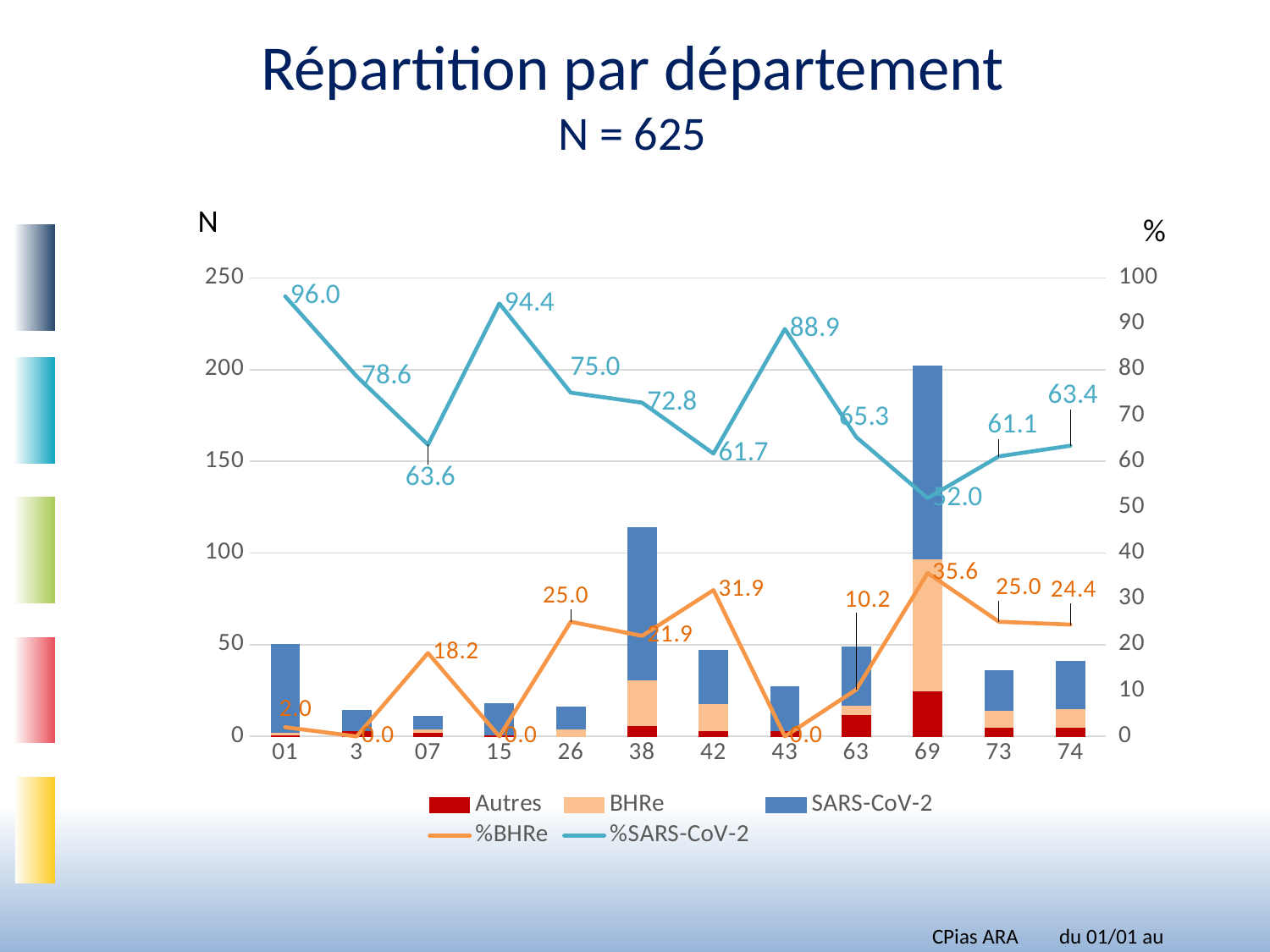
What is the %SARS-CoV-2 value for department 01? 96.0 Which department has the highest %BHRe value? 69 How many departments are shown on the x axis? 12 Which department has the highest %SARS-CoV-2 value? 01 What kind of chart is shown on the slide? Combination stacked bar and line chart What is the %BHRe value for department 69? 35.6 Which department has the lowest %SARS-CoV-2 value? 69 Which has the larger %BHRe value, department 42 or department 38? 42 What is the %SARS-CoV-2 value for department 43? 88.9 How many series does the legend list? 5 What is the difference between the %SARS-CoV-2 values for departments 01 and 69? 44.0 Is the total height of the stacked bar for department 69 greater or less than 150? greater